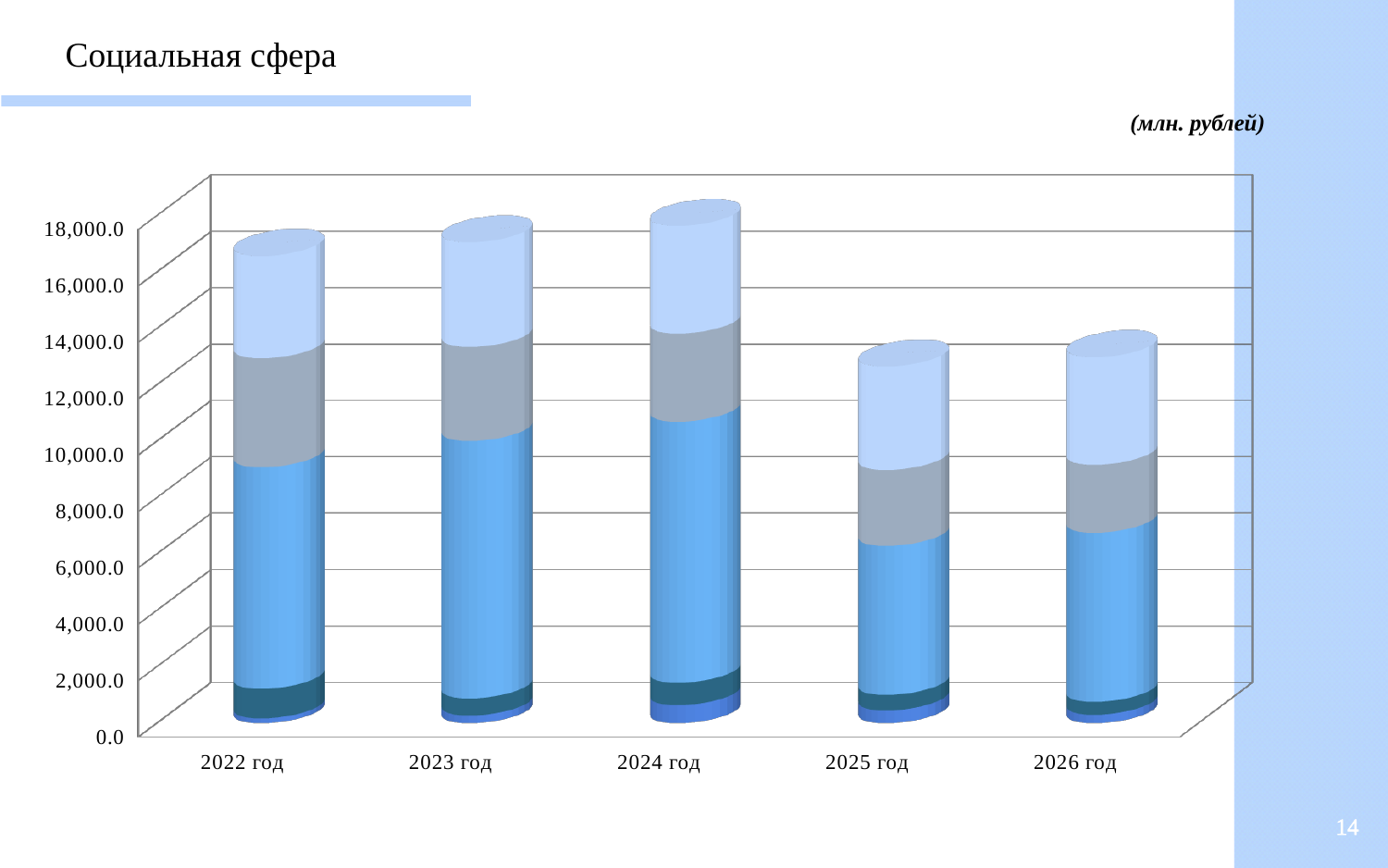
Is the total bar for 2024 год greater or less than 16,000.0? greater Which bar is taller, 2024 год or 2025 год? 2024 год How many years (categories) are shown on the x axis of the chart? 5 Do the bar totals rise or fall from 2022 год to 2024 год? rise Do the bar totals rise or fall from 2024 год to 2025 год? fall What is the title of the slide containing the chart? Социальная сфера Which bar is taller, 2022 год or 2025 год? 2022 год Is the total bar for 2025 год greater or less than 14,000.0? less Is the total bar for 2022 год greater or less than 14,000.0? greater In what units are the chart values given, according to the slide? млн. рублей Which year has the tallest bar in the chart? 2024 год What kind of chart is shown on the slide? Stacked bar chart